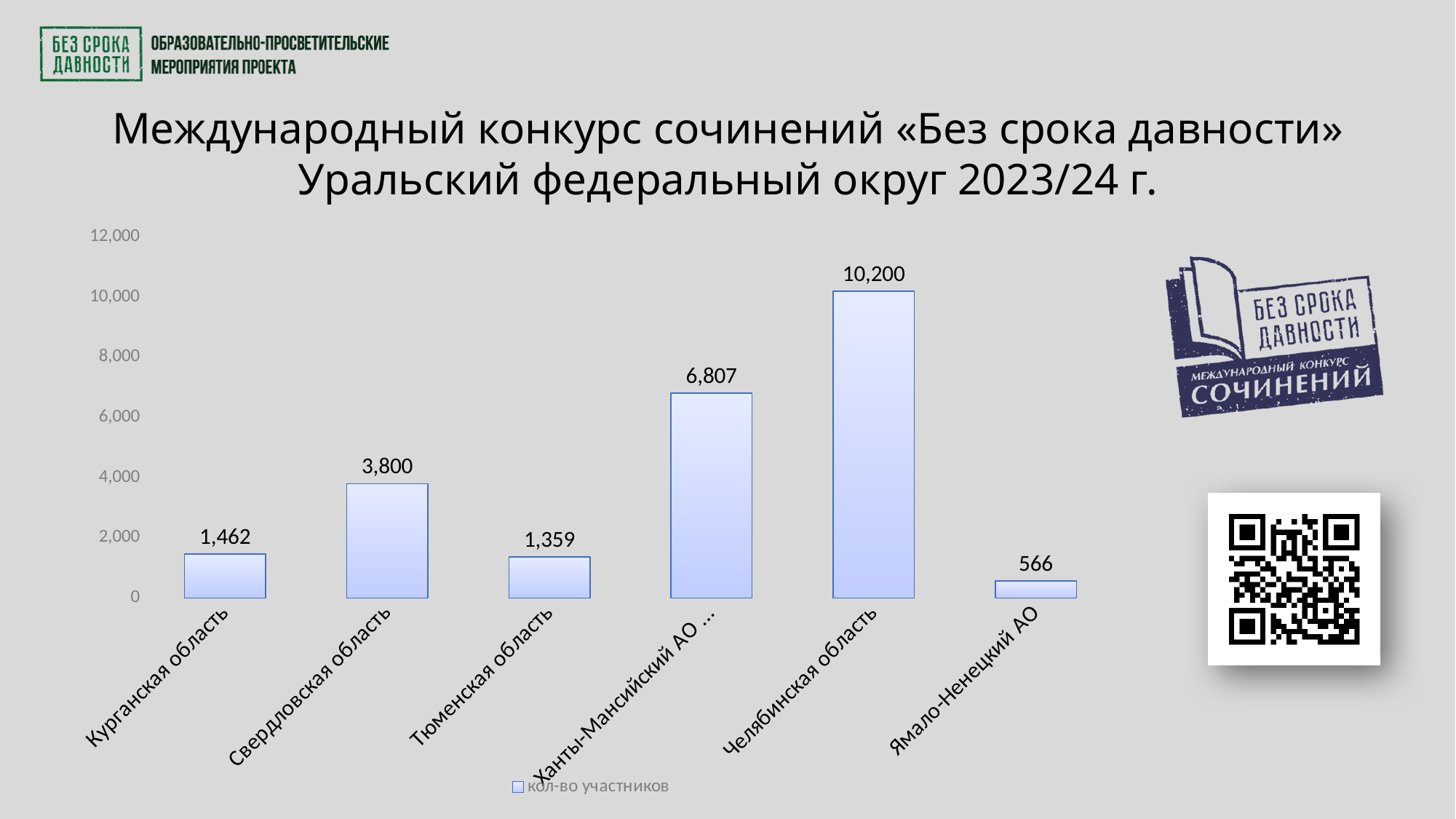
Which category has the highest value? Челябинская область What is the difference between the values for Курганская область and Тюменская область? 103 How many categories are shown on the chart? 6 Is the value for Челябинская область greater or less than 10,000? greater Which category has the lowest value? Ямало-Ненецкий АО What is the value for Челябинская область? 10,200 What kind of chart is shown on the slide? bar chart What is the difference between the values for Челябинская область and Свердловская область? 6,400 What is the value for Свердловская область? 3,800 Which is larger, the value for Курганская область or the value for Тюменская область? Курганская область What series name does the legend show? кол-во участников What is the value for Ямало-Ненецкий АО? 566